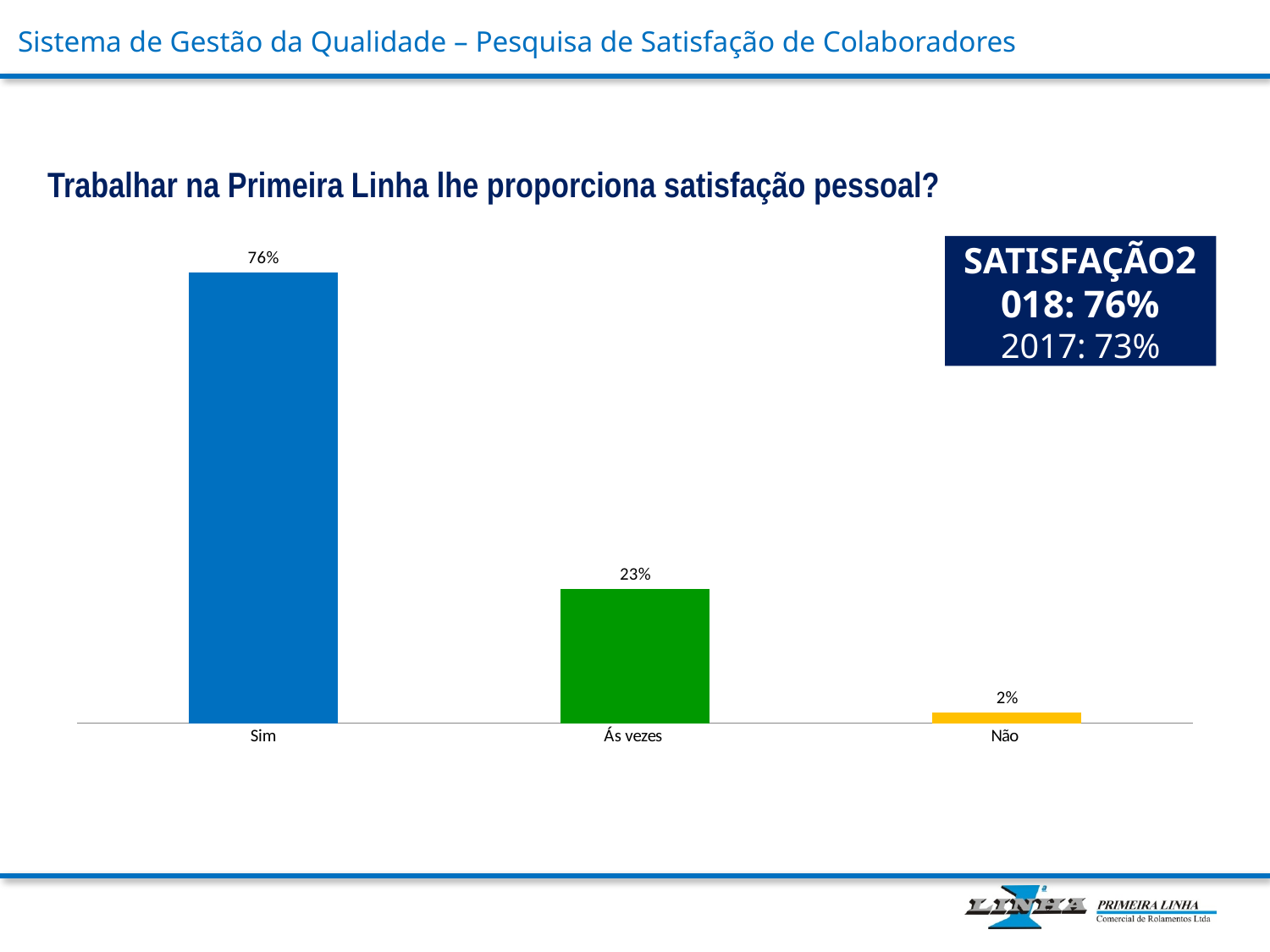
What is the value for Não? 2% What is the value for Ás vezes? 23% Which is larger, the value for Ás vezes or the value for Não? Ás vezes Do the values rise or fall from left to right across the categories? Fall How many categories are shown in the chart? 3 What is the difference between the values for Sim and Ás vezes? 53% What colour is the bar for Sim? Blue What is the value for Sim? 76% Which category has the lowest value? Não Which category has the highest value? Sim What kind of chart is shown on the slide? Bar chart What is the difference between the values for Ás vezes and Não? 21%